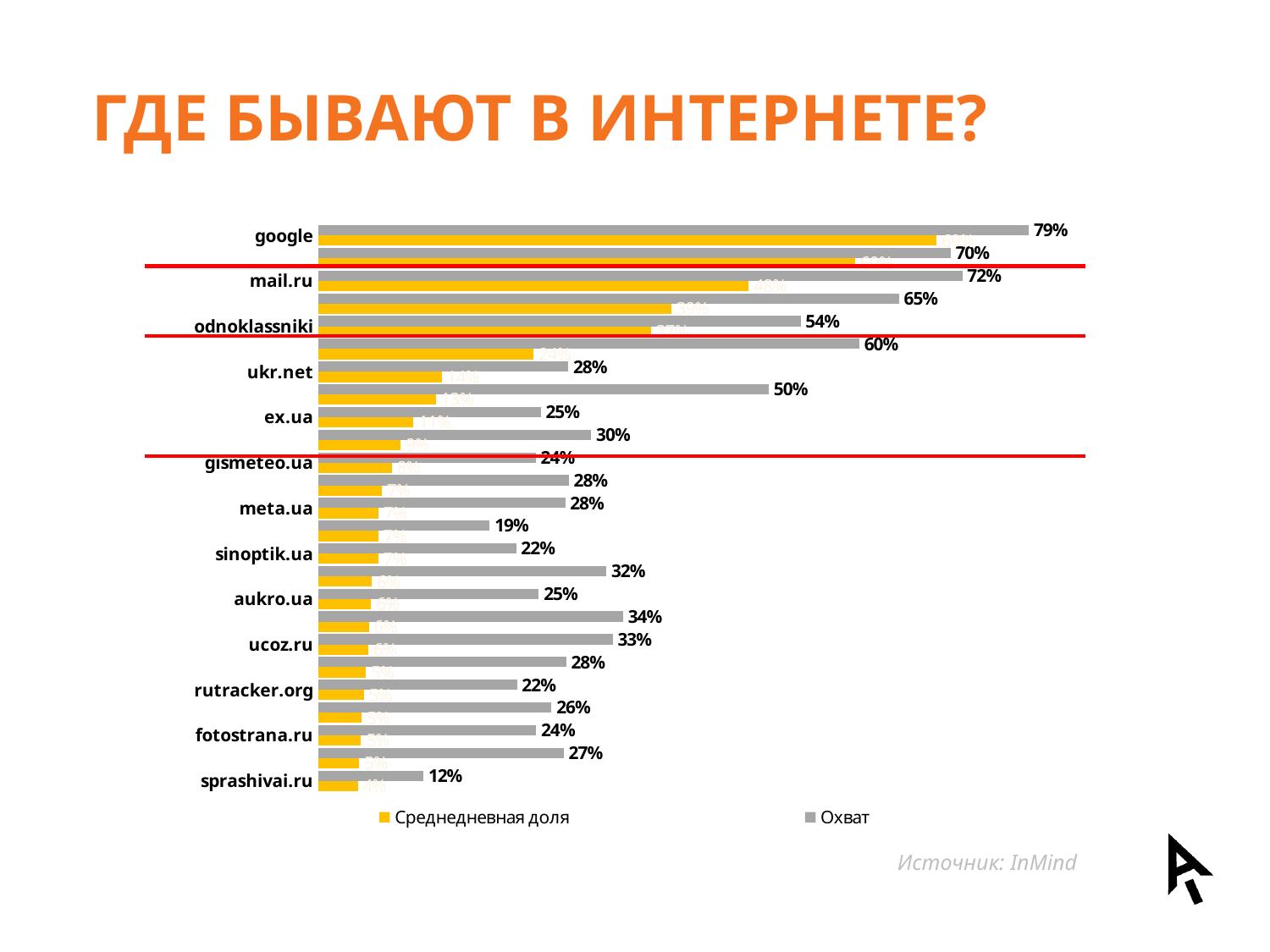
What is the Охват value for sprashivai.ru? 12% What is the Охват value for mail.ru? 72% Which labelled site has the highest Охват value? google How many series does the legend list? 2 What are the two series named in the legend? Среднедневная доля and Охват What is the Охват value for ucoz.ru? 33% What kind of chart is shown on the slide? bar chart What is the Охват value for google? 79% Which labelled site has the lowest Охват value? sprashivai.ru Which has a larger Охват value, ukr.net or ex.ua? ukr.net What is the Охват value for odnoklassniki? 54% What is the difference between the Охват values for google and mail.ru? 7%